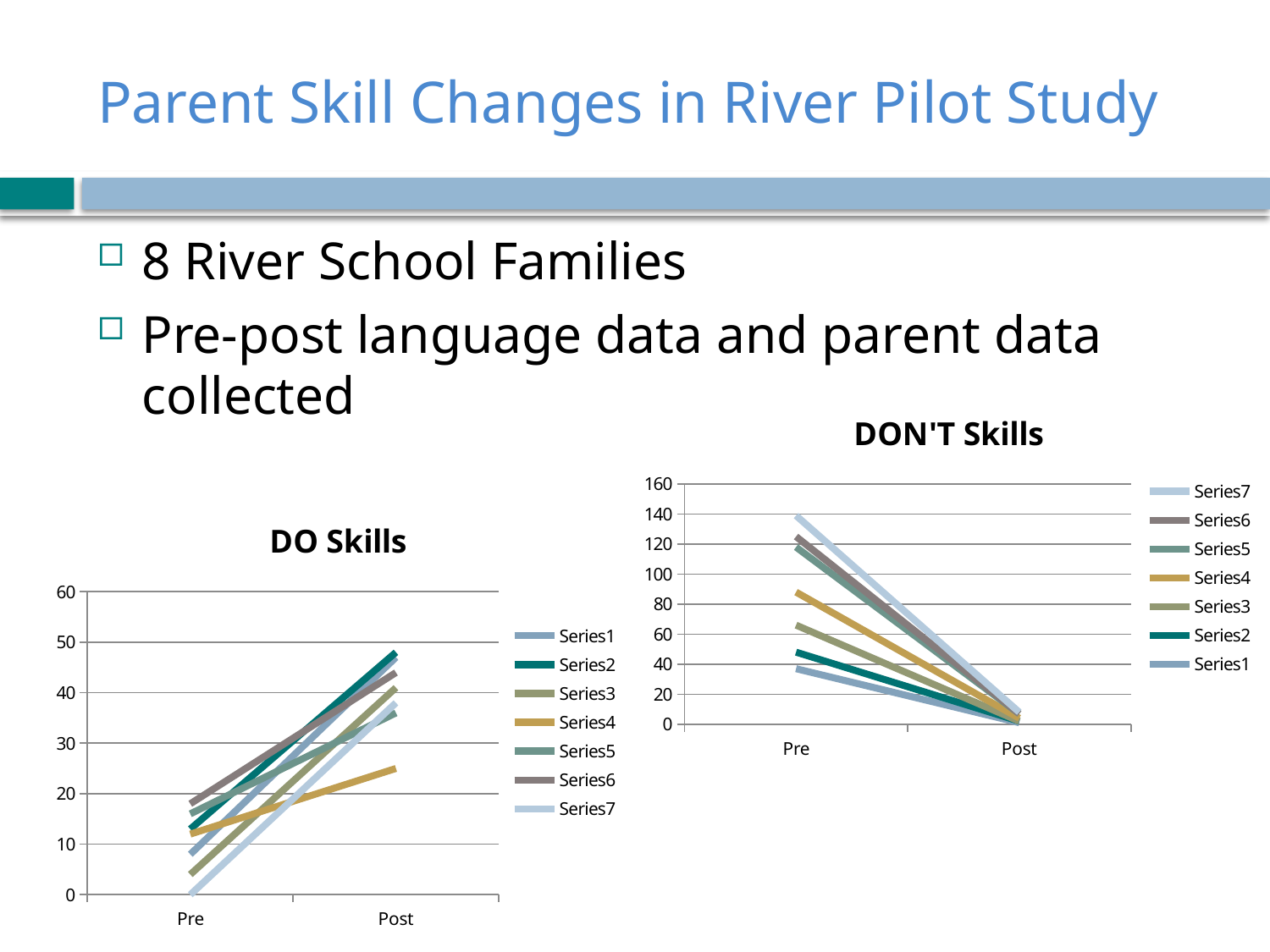
What kind of chart is the DO Skills chart? line chart In the DON'T Skills chart, which series has the highest Pre value? Series7 In the DON'T Skills chart, is the Pre value for Series7 greater or less than 120? greater In the DON'T Skills chart, do the series values rise or fall from Pre to Post? fall In the DO Skills chart, which series has the lowest Post value? Series4 In the DON'T Skills chart, is the Pre value for Series1 greater or less than 60? less In the DO Skills chart, is the Post value for Series4 greater or less than 30? less How many series does the legend of the DON'T Skills chart list? 7 In the DO Skills chart, do the series values rise or fall from Pre to Post? rise How many categories are on the x axis of the DON'T Skills chart? 2 How many series does the legend of the DO Skills chart list? 7